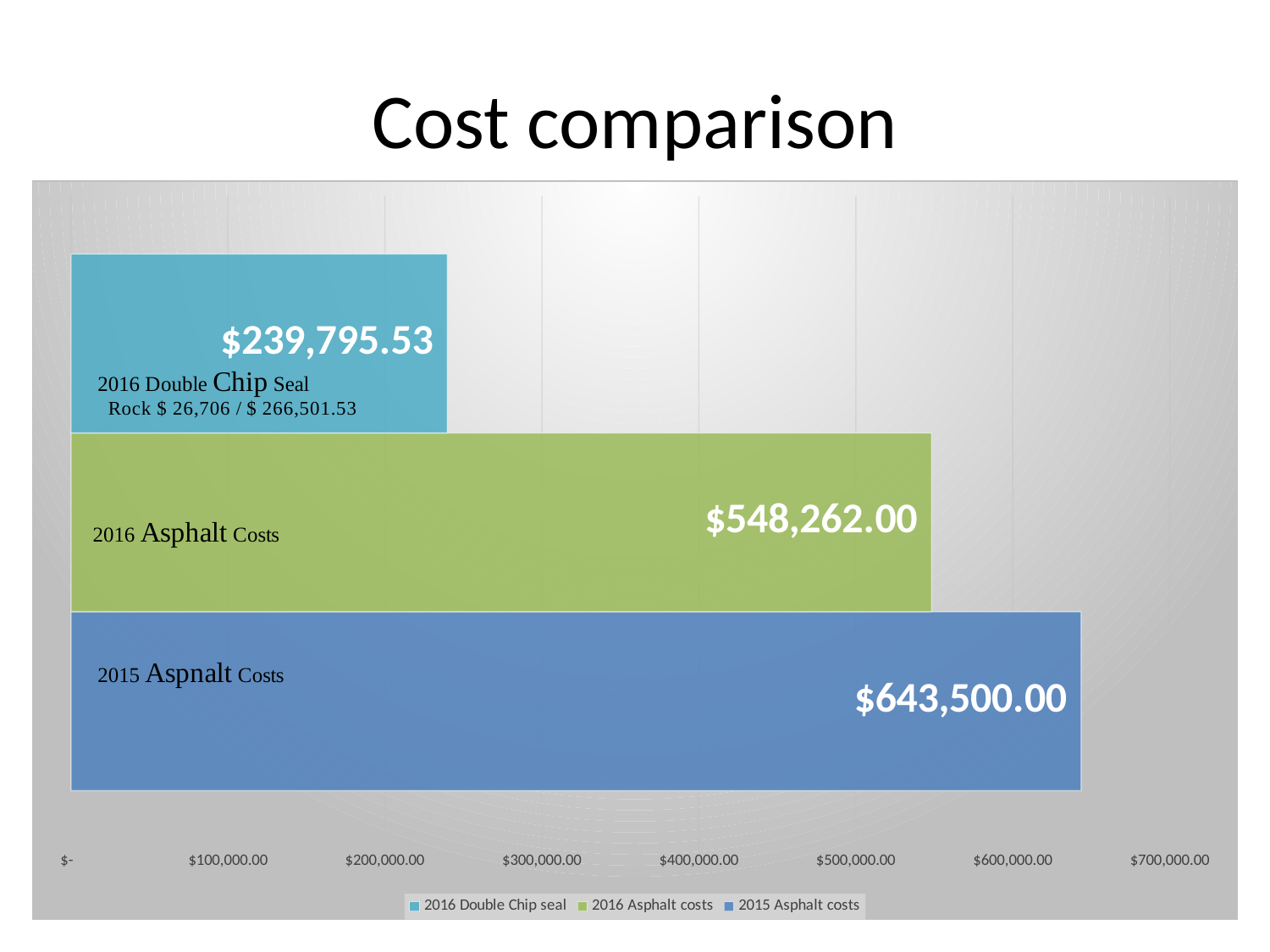
What is the difference between the 2016 Asphalt costs and the 2016 Double Chip seal cost? $308,466.47 What is the value shown for 2015 Asphalt costs? $643,500.00 What kind of chart is shown on the slide? Bar chart What is the difference between the 2015 Asphalt costs and the 2016 Asphalt costs? $95,238.00 Is the value for 2016 Asphalt costs greater or less than $500,000.00? greater What is the value shown for 2016 Double Chip seal? $239,795.53 Which category has the lowest cost? 2016 Double Chip seal What is the value shown for 2016 Asphalt costs? $548,262.00 Which is larger, the 2016 Asphalt costs or the 2016 Double Chip seal cost? 2016 Asphalt costs How many bars are plotted in the chart? 3 Which category has the highest cost? 2015 Asphalt costs How many series does the legend list? 3